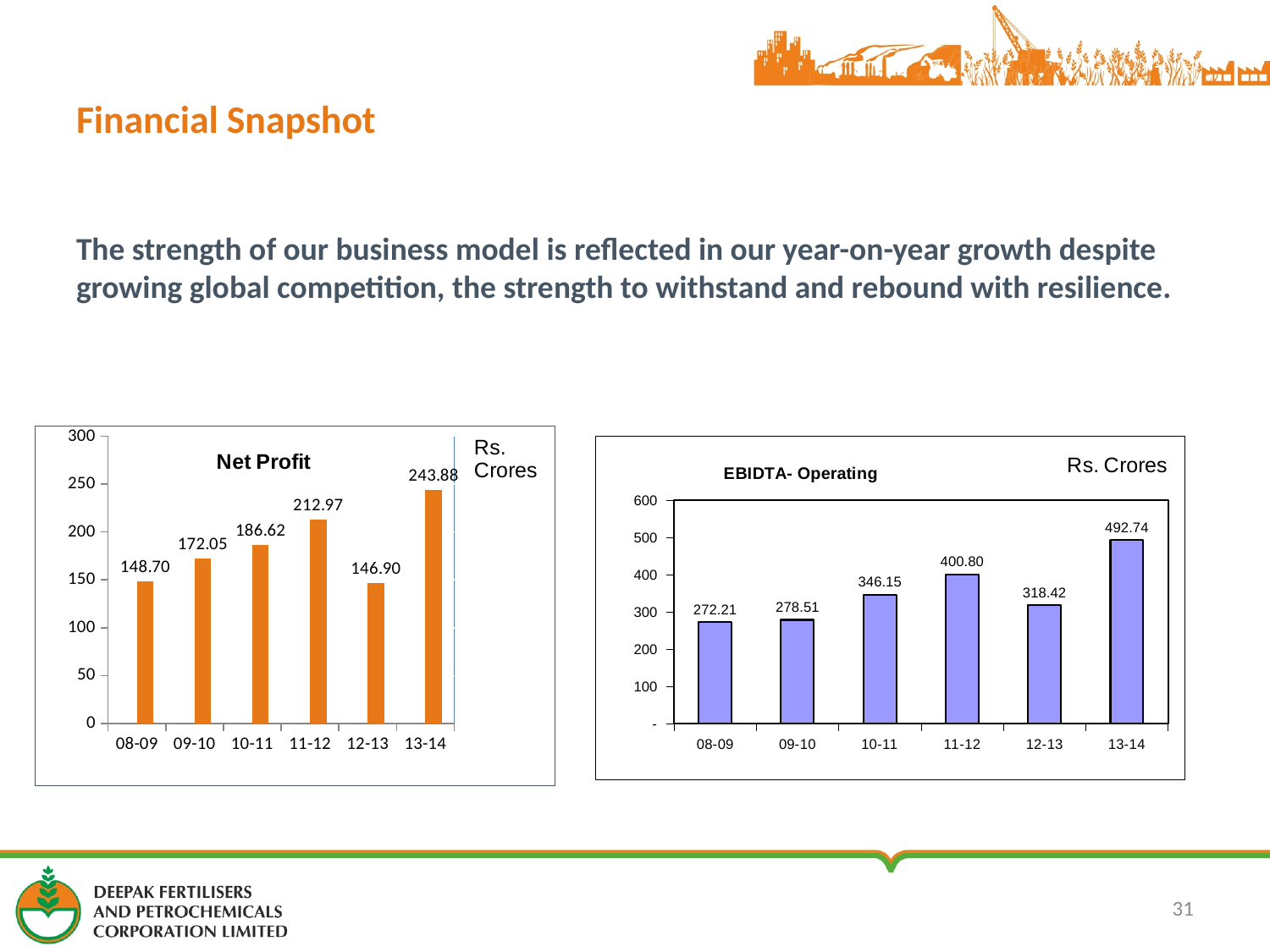
How many years are shown in the EBIDTA- Operating chart? 6 In the EBIDTA- Operating chart, what is the value for 10-11? 346.15 In the Net Profit chart, which year has the lowest value? 12-13 In the EBIDTA- Operating chart, which is larger, the value for 11-12 or the value for 12-13? 11-12 What kind of chart is the Net Profit chart? bar chart In the Net Profit chart, what is the value for 11-12? 212.97 In the Net Profit chart, which year has the highest value? 13-14 What unit is stated for the values in the EBIDTA- Operating chart? Rs. Crores In the EBIDTA- Operating chart, what is the difference between the 13-14 and 11-12 values? 91.94 In the Net Profit chart, what is the difference between the 13-14 and 12-13 values? 96.98 In the Net Profit chart, is the value for 09-10 greater or less than 150? greater In the EBIDTA- Operating chart, which year has the lowest value? 08-09